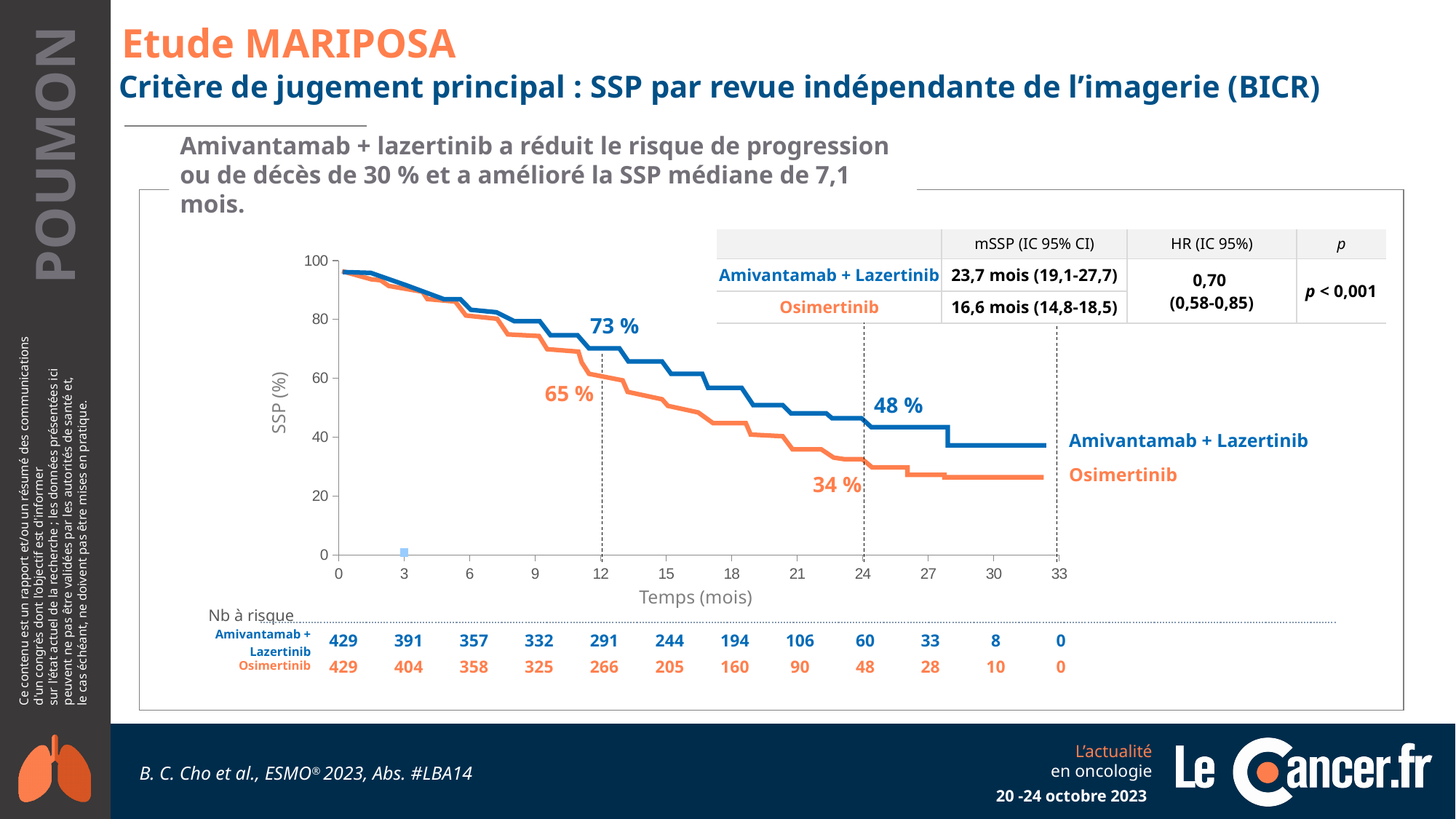
Which arm has the higher SSP rate at 12 months, Amivantamab + Lazertinib or Osimertinib? Amivantamab + Lazertinib What is the hazard ratio (HR) shown in the table? 0,70 (0,58-0,85) What is the SSP rate at 24 months for Amivantamab + Lazertinib? 48 % What kind of chart is shown on the slide? Line chart (Kaplan-Meier survival curve) Do the SSP curves rise or fall as time (months) increases? Fall How many patients were at risk in the Osimertinib arm at 18 months? 160 What is the median SSP for the Osimertinib arm according to the table? 16,6 mois (14,8-18,5) What is the SSP rate at 12 months for Osimertinib? 65 % What is the difference in SSP rate at 24 months between Amivantamab + Lazertinib and Osimertinib? 14 % What is the SSP rate at 12 months for Amivantamab + Lazertinib? 73 % What is the SSP rate at 24 months for Osimertinib? 34 % How many treatment arms (series) are plotted on the chart? 2